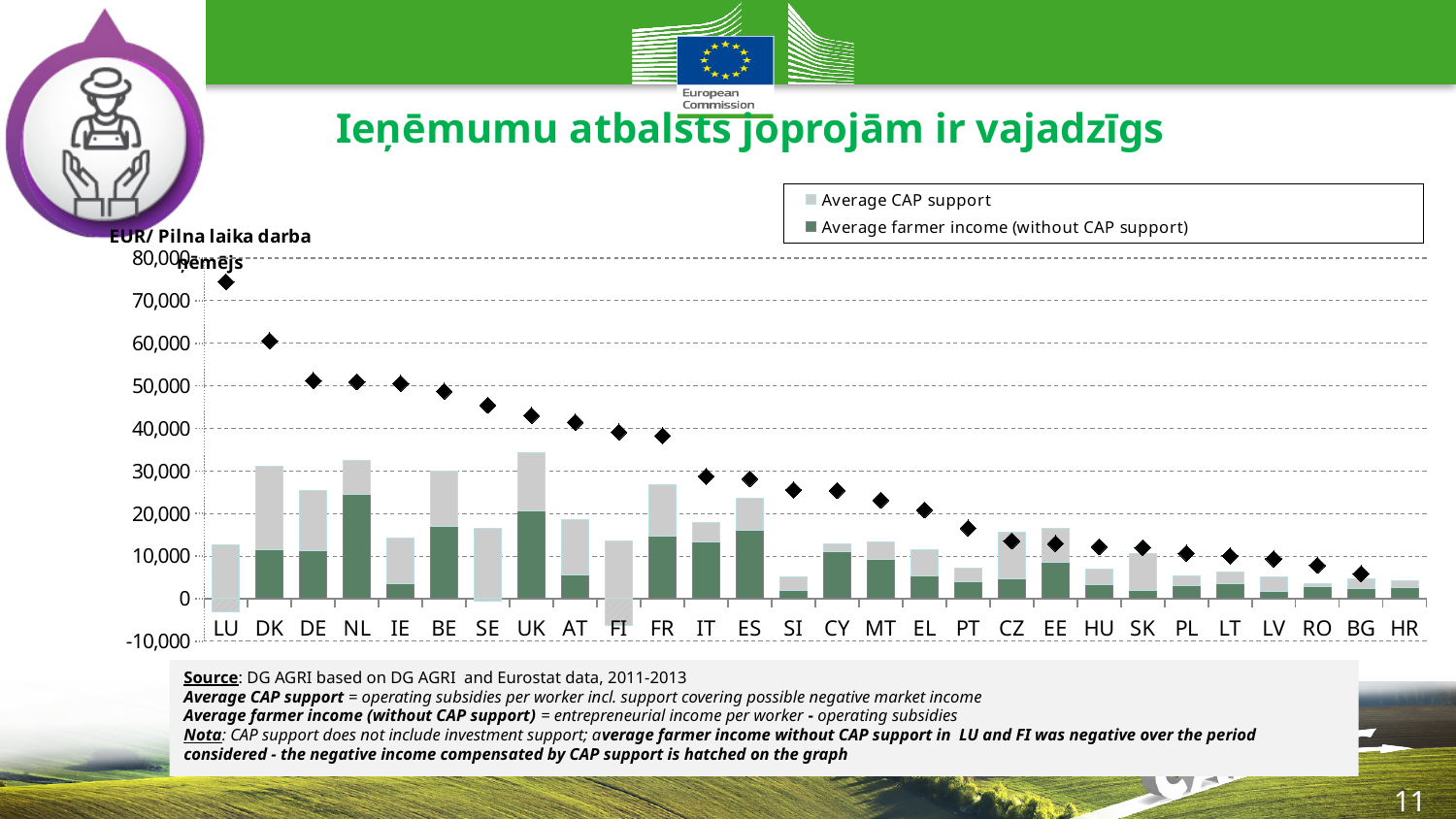
Is the diamond marker for UK greater or less than 40,000? greater Do the diamond markers rise or fall moving from left to right along the x axis? fall Is the diamond marker for LU greater or less than 70,000? greater Is the diamond marker for FR greater or less than 40,000? less What kind of chart is shown on the slide? combination chart (stacked bar chart with diamond markers) Which country has the tallest Average farmer income (without CAP support) bar? NL How many countries are shown along the x axis of the chart? 28 How many series does the chart legend list? 2 What is the title of the slide containing the chart? Ieņēmumu atbalsts joprojām ir vajadzīgs Which country has the highest diamond marker on the chart? LU